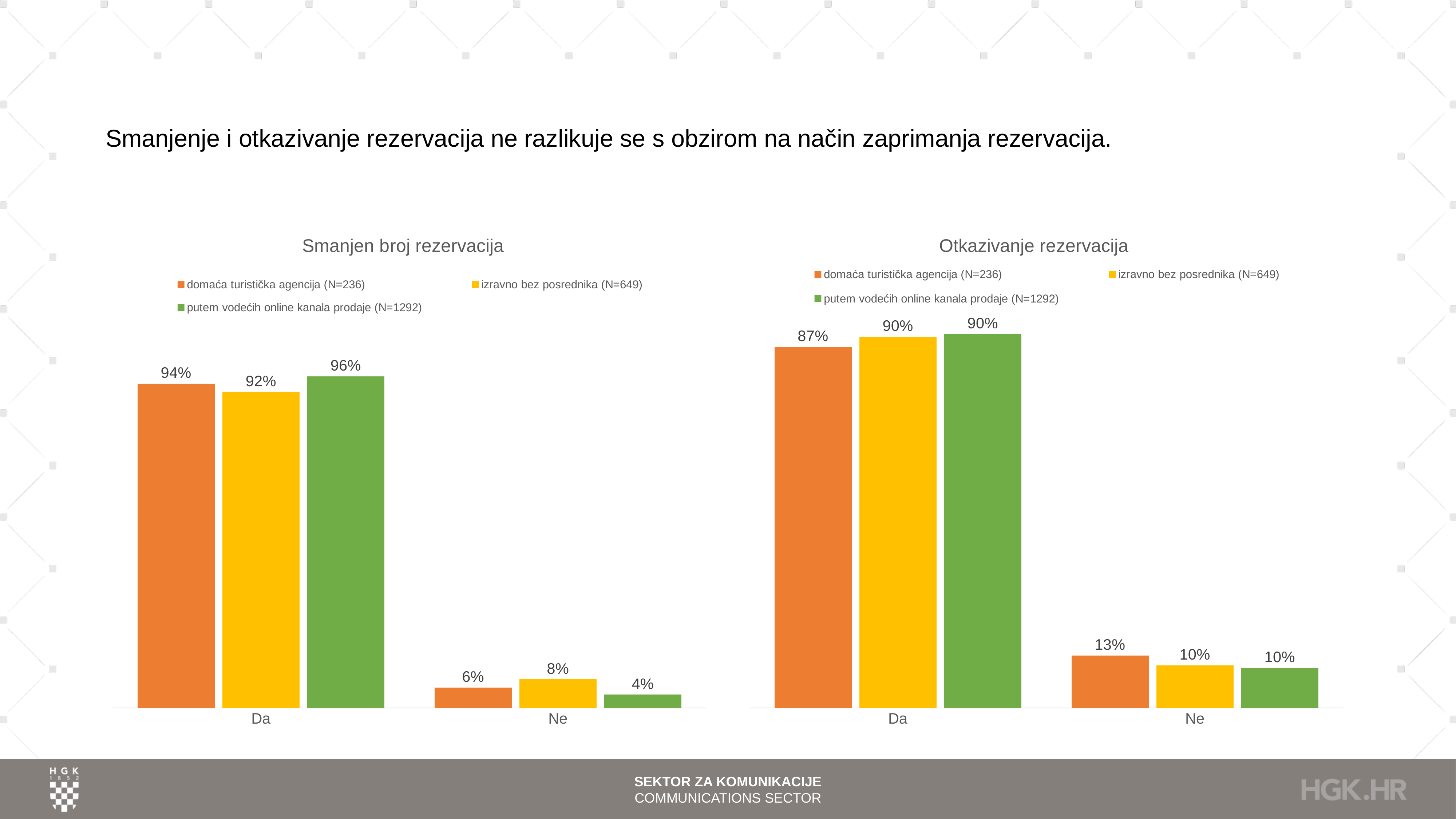
How many series does the legend of the 'Otkazivanje rezervacija' chart list? 3 What kind of chart is the 'Otkazivanje rezervacija' chart? bar chart In the 'Smanjen broj rezervacija' chart, which series has the highest value in the 'Da' category? putem vodećih online kanala prodaje (N=1292) In the 'Otkazivanje rezervacija' chart, what is the value for 'domaća turistička agencija (N=236)' in the 'Ne' category? 13% In the 'Smanjen broj rezervacija' chart, what is the difference between the 'Da' values for 'putem vodećih online kanala prodaje (N=1292)' and 'izravno bez posrednika (N=649)'? 4% In the 'Smanjen broj rezervacija' chart, what is the value for 'putem vodećih online kanala prodaje (N=1292)' in the 'Da' category? 96% In the 'Otkazivanje rezervacija' chart, what is the difference between the 'Ne' values for 'domaća turistička agencija (N=236)' and 'izravno bez posrednika (N=649)'? 3% In the 'Smanjen broj rezervacija' chart, which is larger in the 'Ne' category: 'domaća turistička agencija (N=236)' or 'putem vodećih online kanala prodaje (N=1292)'? domaća turistička agencija (N=236) In the 'Smanjen broj rezervacija' chart, what is the value for 'izravno bez posrednika (N=649)' in the 'Ne' category? 8% In the 'Smanjen broj rezervacija' chart, what colour represents 'izravno bez posrednika (N=649)'? yellow How many categories are shown on the x axis of the 'Smanjen broj rezervacija' chart? 2 In the 'Otkazivanje rezervacija' chart, which series has the lowest value in the 'Da' category? domaća turistička agencija (N=236)